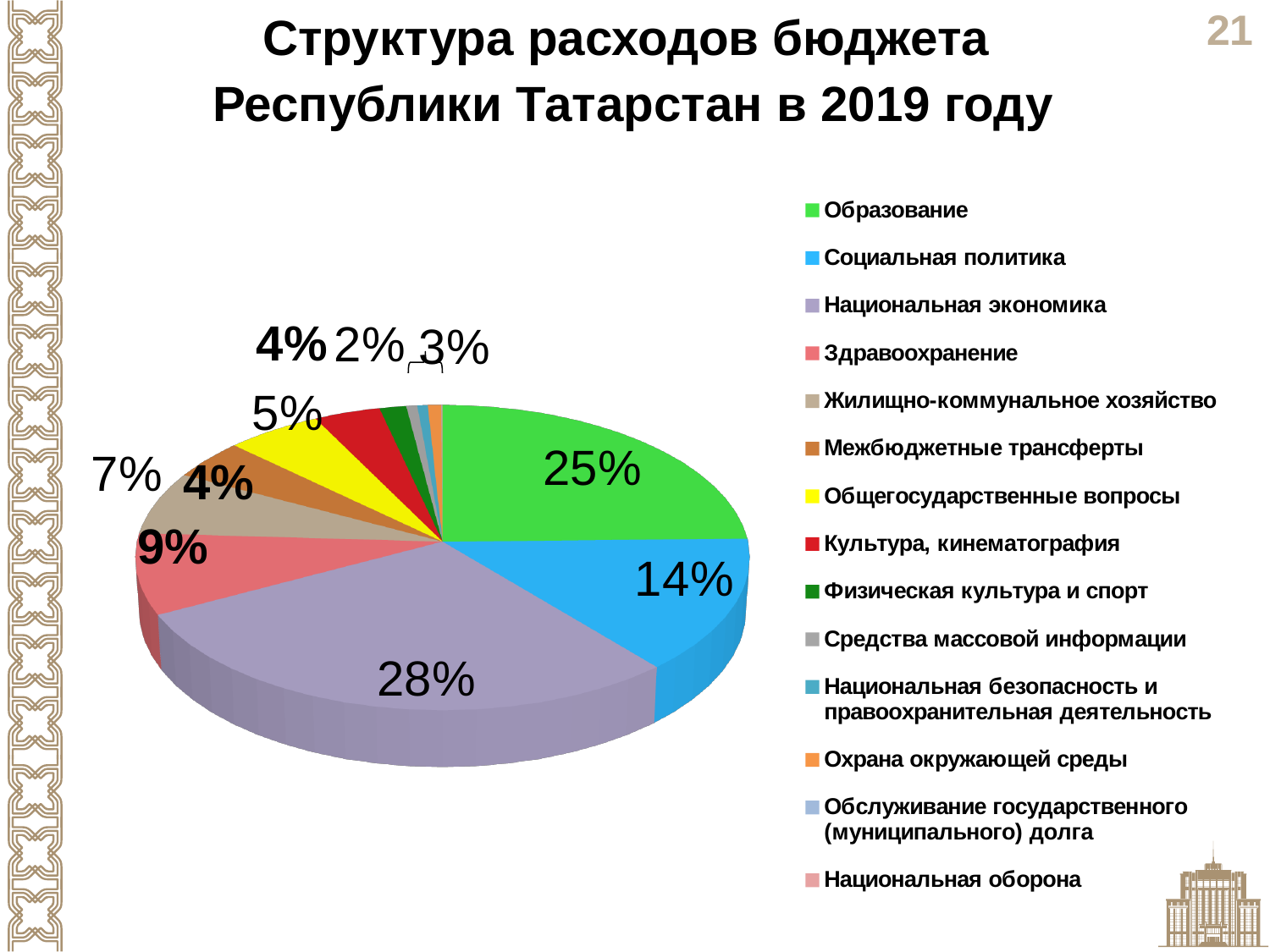
What is the title of the chart? Структура расходов бюджета Республики Татарстан в 2019 году What share of the budget expenditure goes to Образование? 25% What share of the budget expenditure goes to Общегосударственные вопросы? 5% What share of the budget expenditure goes to Социальная политика? 14% What colour is the slice for Образование? Green What share of the budget expenditure goes to Здравоохранение? 9% What share of the budget expenditure goes to Национальная экономика? 28% How many categories are listed in the legend? 14 What kind of chart is shown on the slide? Pie chart Which category has the largest share of the budget expenditure? Национальная экономика Which has a larger share: Образование or Социальная политика? Образование By how many percentage points does the share of Национальная экономика exceed the share of Образование? 3 percentage points